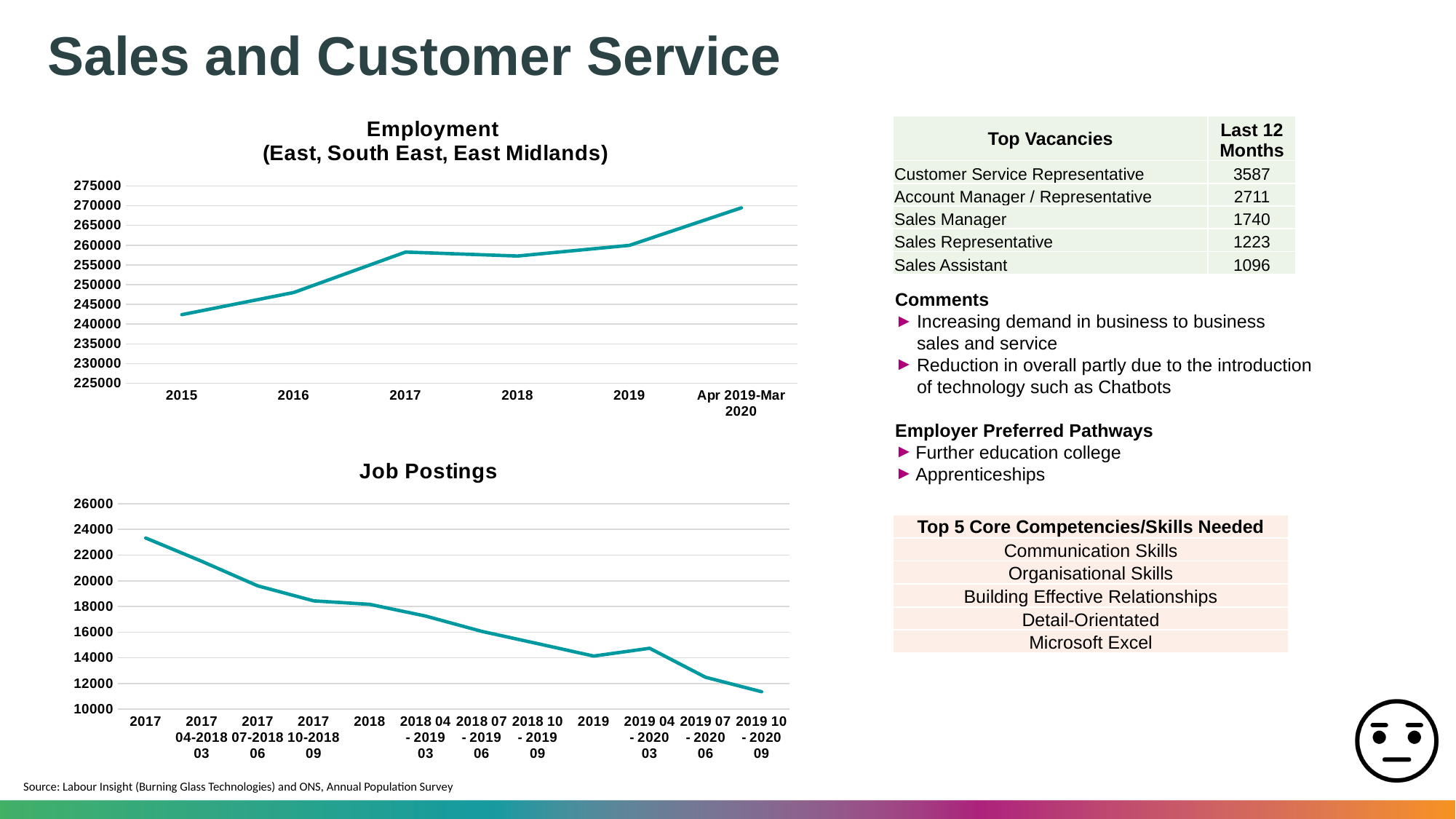
In the Job Postings chart, which period has the highest value? 2017 In the Employment chart, is the value for Apr 2019-Mar 2020 greater or less than 265000? greater In the Job Postings chart, is the value for 2019 greater or less than 16000? less In the Employment chart, is the value for 2015 greater or less than 240000? greater How many data points are plotted in the Employment chart? 6 What kind of chart is the Employment (East, South East, East Midlands) chart? line chart In the Employment chart, which period has the highest employment value? Apr 2019-Mar 2020 In the Employment chart, which year has the lowest employment value? 2015 In the Job Postings chart, which period has the lowest value? 2019 10 - 2020 09 What kind of chart is the Job Postings chart? line chart In the Employment chart, do the values generally rise or fall from 2015 to Apr 2019-Mar 2020? rise In the Job Postings chart, do the values generally rise or fall from 2017 to 2019 10 - 2020 09? fall